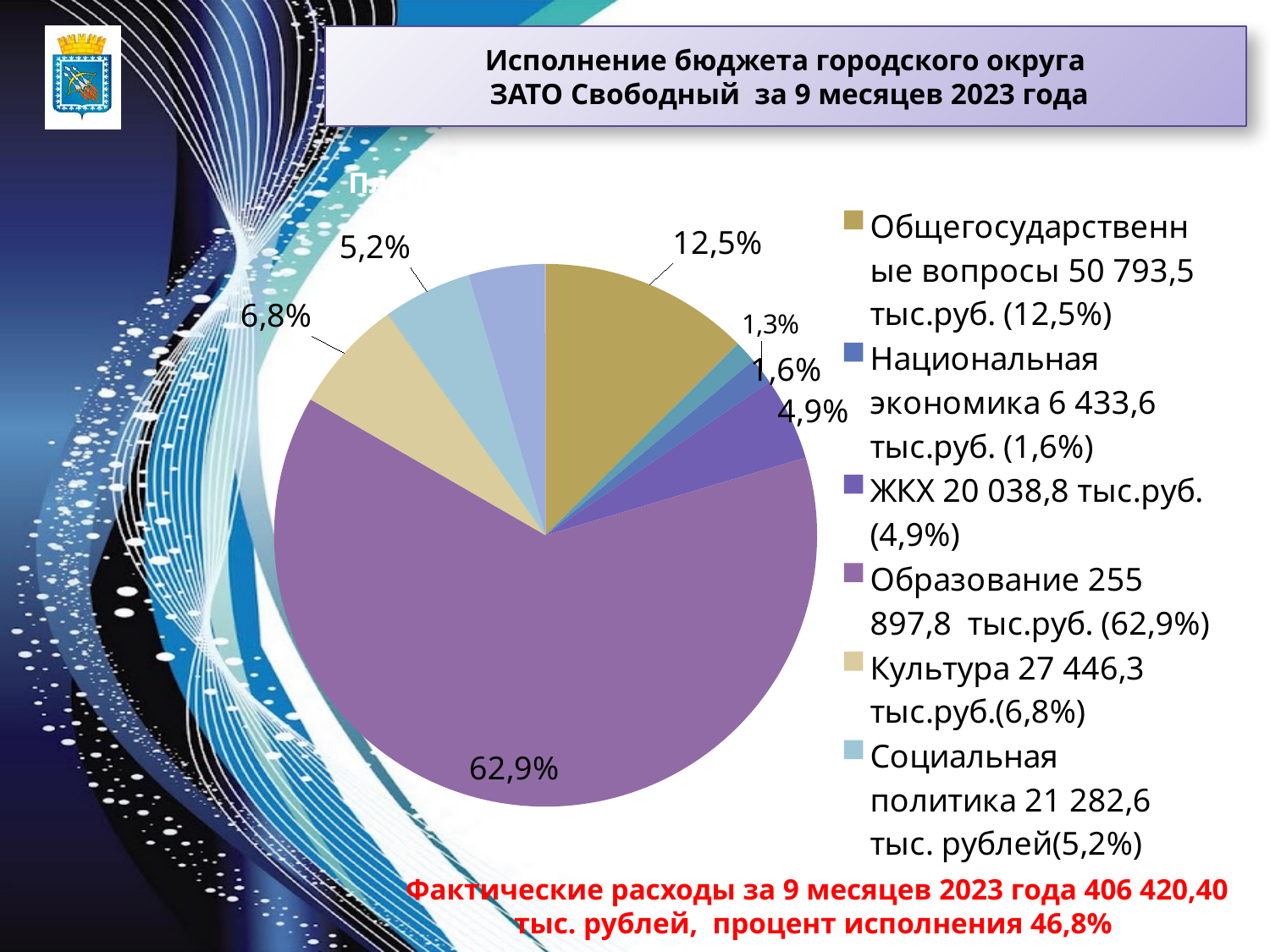
What percentage share is shown for Общегосударственные вопросы? 12,5% What percentage share is shown for Образование? 62,9% How many entries does the legend list? 6 What percentage share is shown for Культура? 6,8% What percentage share is shown for Социальная политика? 5,2% Which is larger, the share for Культура or the share for Социальная политика? Культура What amount in тыс.руб. does the legend give for Образование? 255 897,8 What is the difference in percentage points between the share for Общегосударственные вопросы and the share for Культура? 5,7 What kind of chart is shown on the slide? pie chart What percentage share is shown for ЖКХ? 4,9% What is the smallest percentage label printed on the pie? 1,3% Which category has the largest slice of the pie? Образование